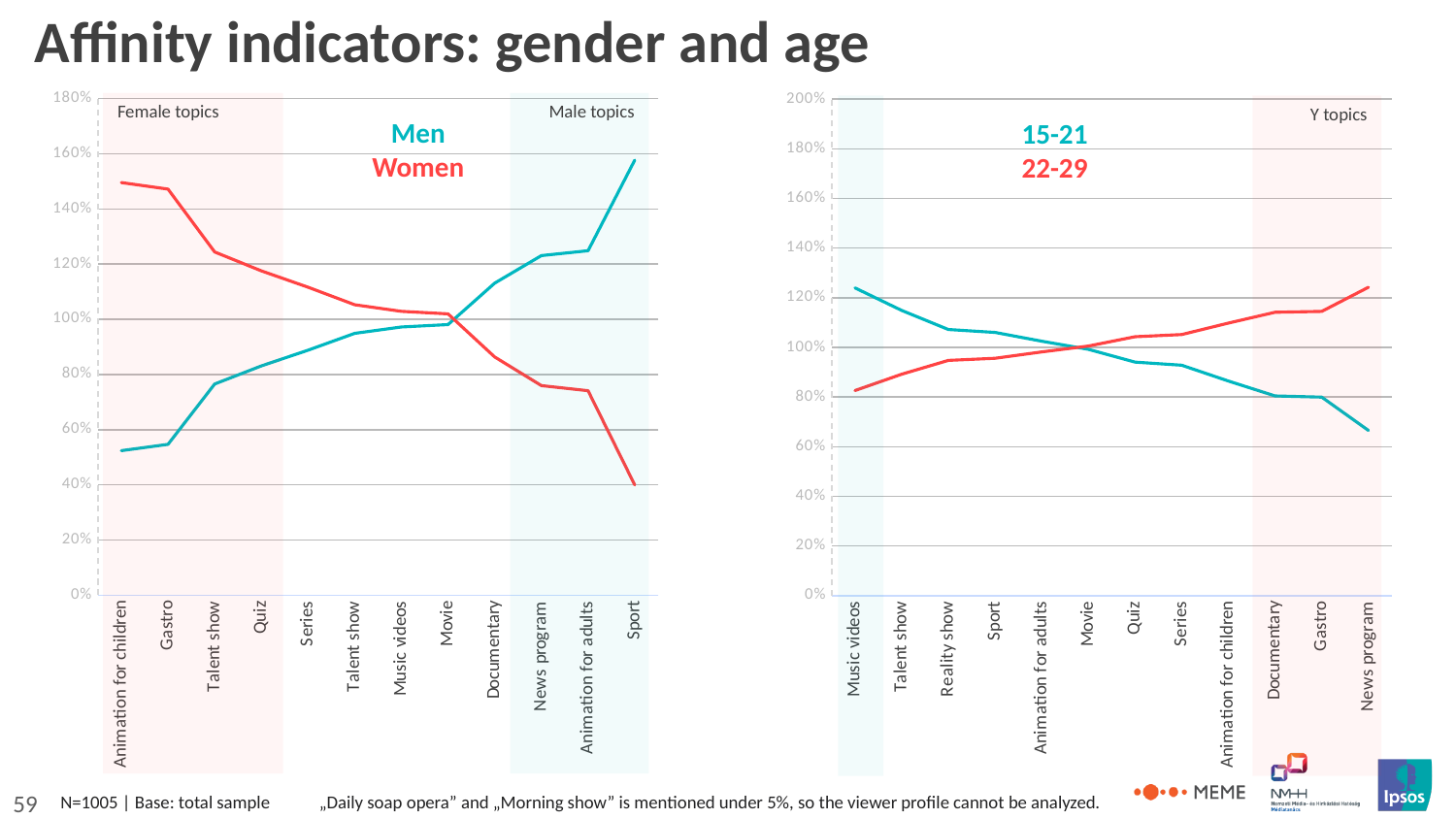
In the left chart, which is larger at Animation for children: the Men value or the Women value? Women In the left chart, for which category is the Men line highest? Sport In the left chart, does the Men line rise or fall from Animation for children to Sport? rise In the left chart, is the Women value for Animation for adults greater or less than 80%? less In the right chart, is the 15-21 value for News program greater or less than 80%? less What kind of chart is the left chart on the slide? line chart In the right chart, which is larger at Music videos: the 15-21 value or the 22-29 value? 15-21 In the left chart, is the Men value for Sport greater or less than 140%? greater In the left chart, for which category is the Women line lowest? Sport How many series does the right chart (15-21 / 22-29) plot? 2 In the right chart, for which category is the 15-21 line lowest? News program How many categories are shown on the x axis of the left chart (Men/Women)? 12